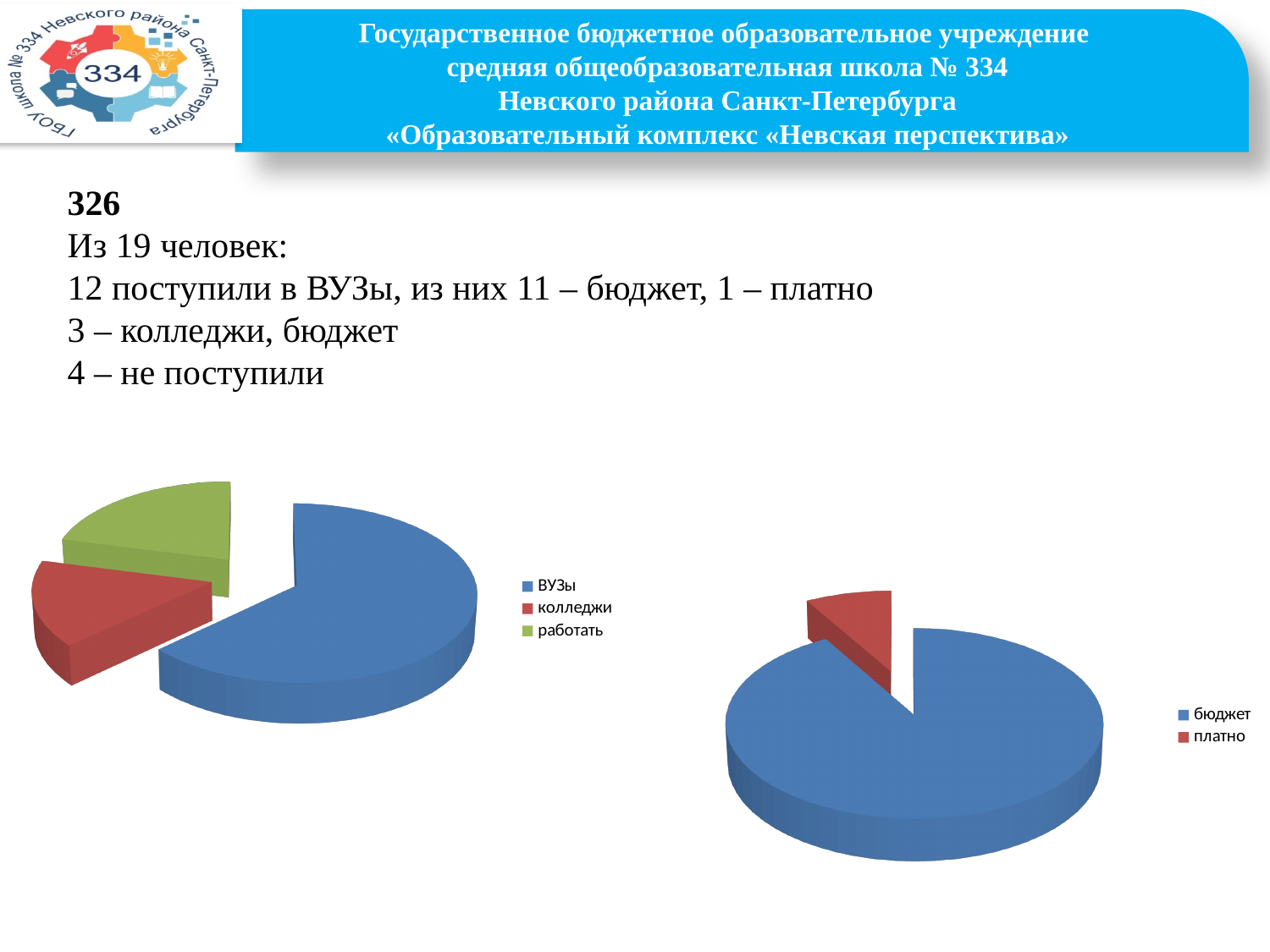
In the right pie chart, which category has the smallest slice? платно What kind of chart is the left chart on the slide? pie chart What kind of chart is the right chart on the slide? pie chart In the left pie chart, which category has the largest slice? ВУЗы In the left pie chart, which slice is larger: ВУЗы or работать? ВУЗы In the right pie chart, what colour is the slice for платно? red In the left pie chart, how many categories does the legend list? 3 In the right pie chart, which slice is larger: бюджет or платно? бюджет In the left pie chart, what colour is the slice for работать? green In the right pie chart, how many categories does the legend list? 2 In the left pie chart, which category has the smallest slice? колледжи In the right pie chart, which category has the largest slice? бюджет